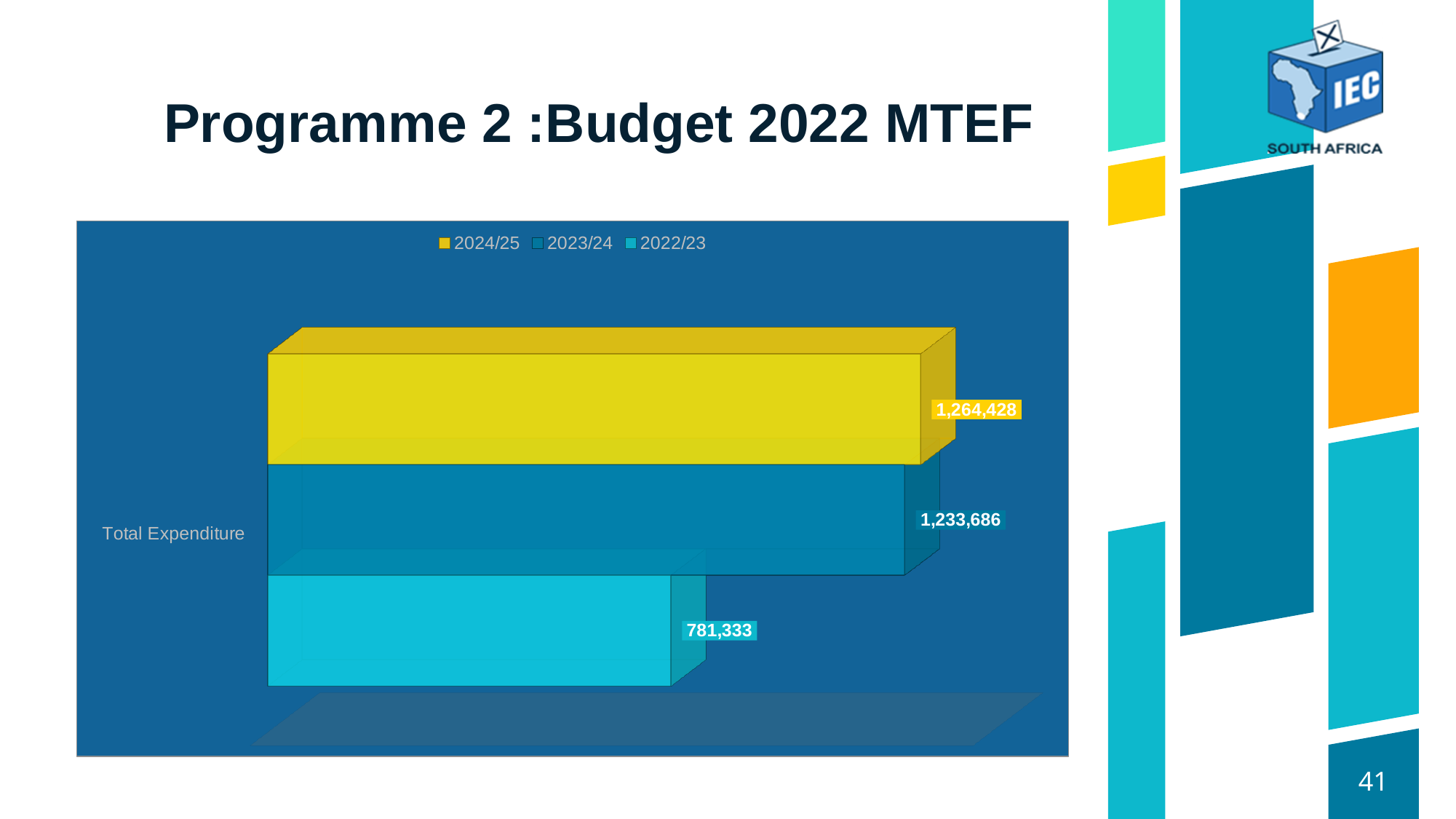
Which year has the lowest Total Expenditure? 2022/23 What is the title of the slide containing the chart? Programme 2 :Budget 2022 MTEF What is the value for 2023/24 for Total Expenditure? 1,233,686 What is the difference between the 2023/24 and 2022/23 values? 452,353 How many series does the legend list? 3 Which is larger, the value for 2023/24 or the value for 2022/23? 2023/24 What is the value for 2024/25 for Total Expenditure? 1,264,428 Do the Total Expenditure values rise or fall from 2022/23 to 2024/25? Rise What is the difference between the 2024/25 and 2023/24 values? 30,742 Which year has the highest Total Expenditure? 2024/25 What is the value for 2022/23 for Total Expenditure? 781,333 What kind of chart is shown on the slide? Bar chart